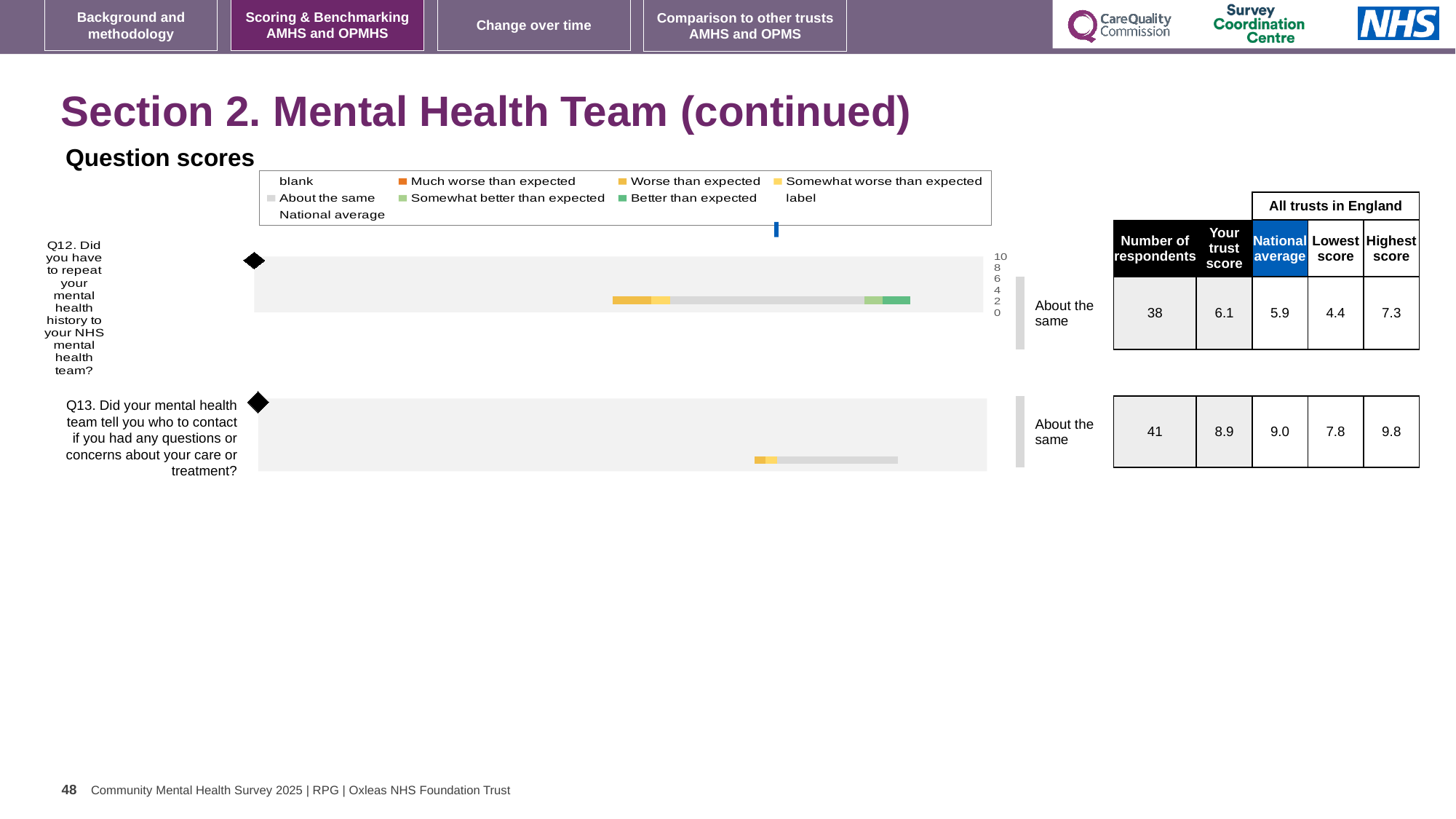
For Q12, what is the difference between the highest score and the lowest score across all trusts in England? 2.9 In the table beside the Q12 chart, what is the trust's score for Q12? 6.1 What is the highest tick value shown on the score axis of the Q12 chart? 10 For Q13, which is larger: the trust's score or the national average? the national average For Q12, which is larger: the trust's score or the national average? the trust's score How many respondents answered Q13 according to the table beside its chart? 41 How many questions (Q12 and Q13) have a score bar plotted on the slide? 2 In the chart legend, what colour represents 'Better than expected'? green What kind of chart is used to show the question scores for Q12 and Q13? bar chart What rating label is shown next to the Q12 chart? About the same In the table beside the Q13 chart, what is the national average score for Q13? 9.0 What rating label is shown next to the Q13 chart? About the same